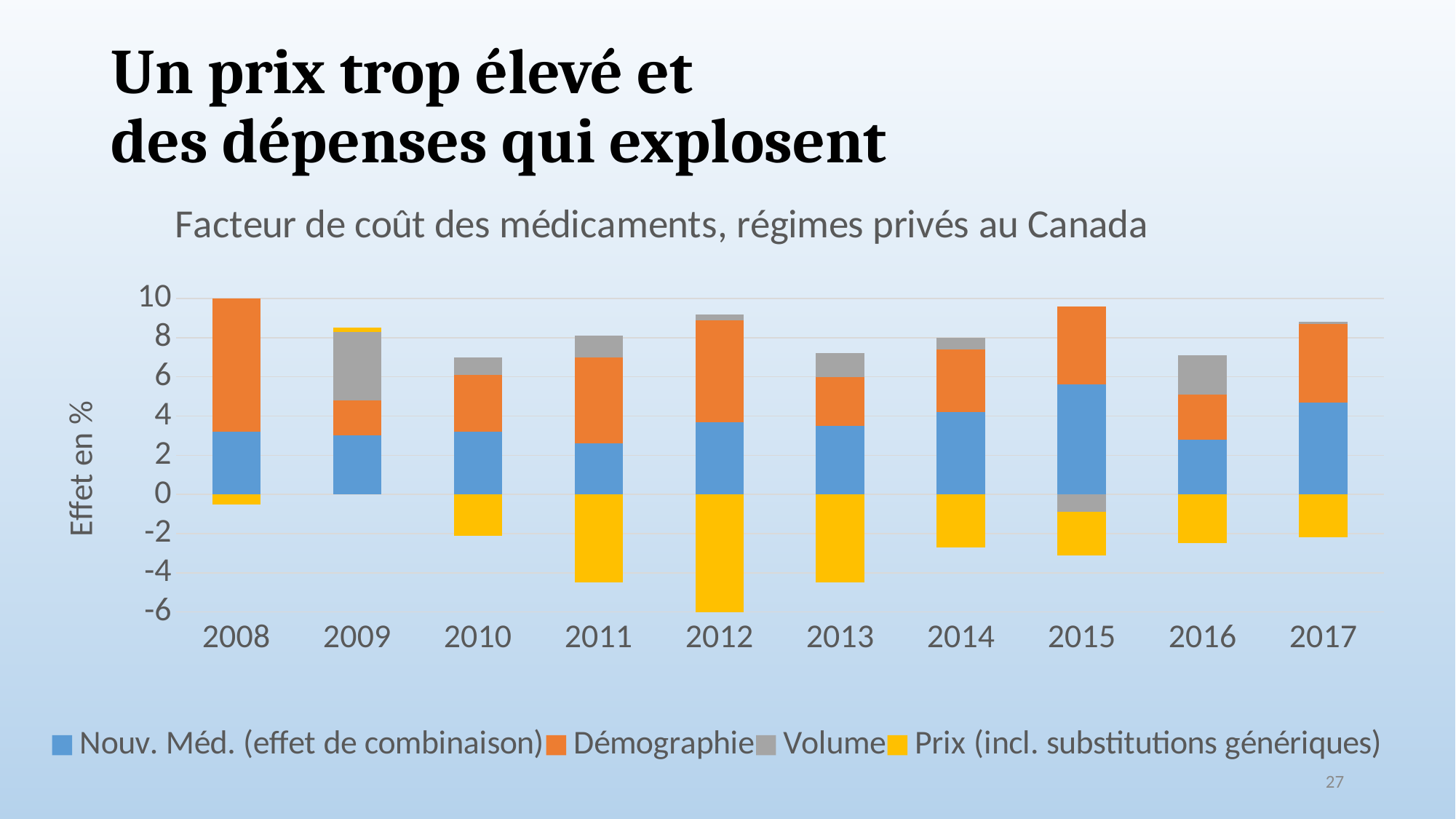
How many series does the chart legend list? 4 What is the label of the vertical axis? Effet en % Is the Nouv. Méd. (effet de combinaison) value for 2015 greater or less than 4? greater What kind of chart is shown on the slide? Stacked bar chart In which year is the Volume segment the largest? 2009 Which year has the larger Démographie segment, 2008 or 2016? 2008 Is the Prix (incl. substitutions génériques) value for 2011 greater or less than -4? less In which year is the Nouv. Méd. (effet de combinaison) segment the largest? 2015 Is the top of the positive stack for 2013 greater or less than 8? less How many years are shown on the x axis of the chart? 10 In which year does the Prix (incl. substitutions génériques) segment reach its most negative value? 2012 What is the title of the chart? Facteur de coût des médicaments, régimes privés au Canada